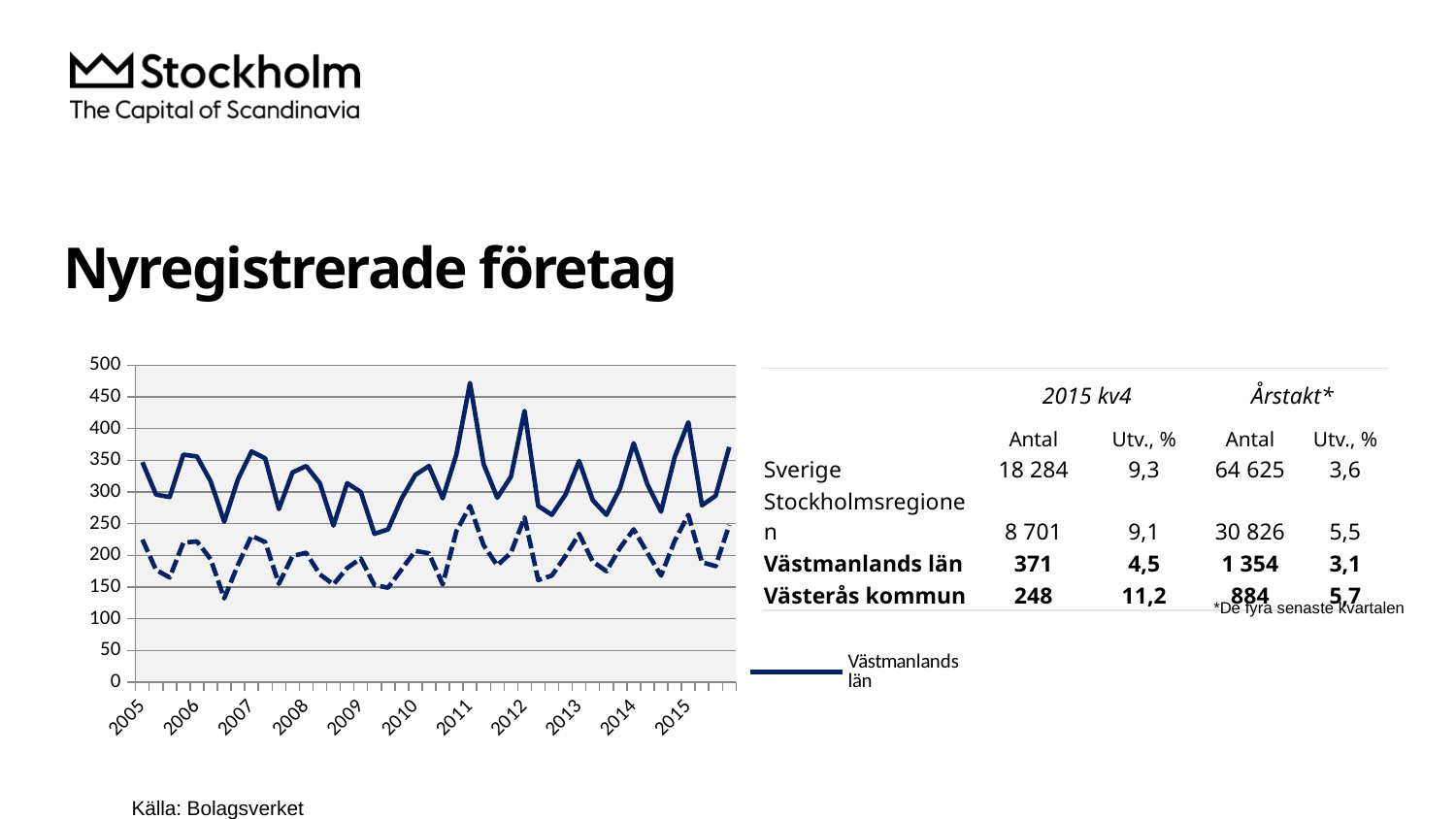
What is the highest value shown on the chart's vertical axis? 500 Which year is the first label on the chart's horizontal axis? 2005 Is the lowest value of the solid Västmanlands län line, around 2009, greater or less than 250? less Which line is higher throughout the chart, the solid Västmanlands län line or the dashed line? the solid Västmanlands län line Which year is the last label on the chart's horizontal axis? 2015 Is the lowest value of the dashed line, around 2007, greater or less than 150? less How many series (lines) are plotted in the chart? 2 Is the peak value of the dashed line, around 2011, greater or less than 250? greater Which series is named in the chart's legend? Västmanlands län How many year labels are shown on the chart's horizontal axis? 11 What kind of chart is shown on the slide? line chart